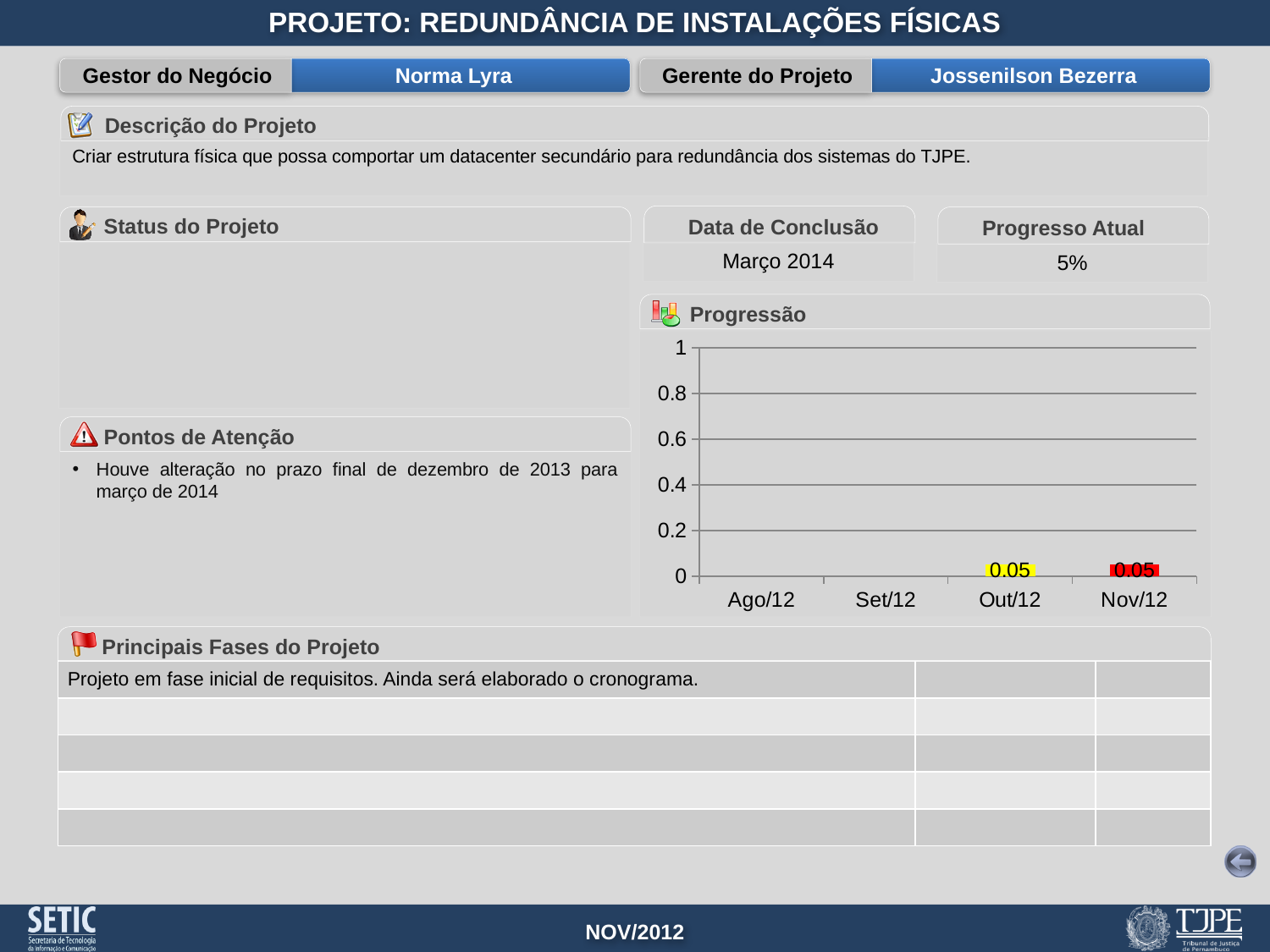
Is the value for Nov/12 in the Progressão chart greater or less than 0.2? less What is the title of the chart on the slide? Progressão What is the highest tick value on the y axis of the Progressão chart? 1 Does the value rise, fall or stay the same from Out/12 to Nov/12 in the Progressão chart? Stays the same Which months in the Progressão chart have no bar plotted? Ago/12 and Set/12 How many categories are shown on the x axis of the Progressão chart? 4 What is the value shown for Out/12 in the Progressão chart? 0.05 What is the difference between the values for Out/12 and Nov/12 in the Progressão chart? 0 Which is larger in the Progressão chart, the value for Out/12 or the value for Nov/12? They are equal (0.05) What is the value shown for Nov/12 in the Progressão chart? 0.05 Is the value for Out/12 in the Progressão chart greater or less than 0.4? less What kind of chart is the Progressão chart? Bar chart